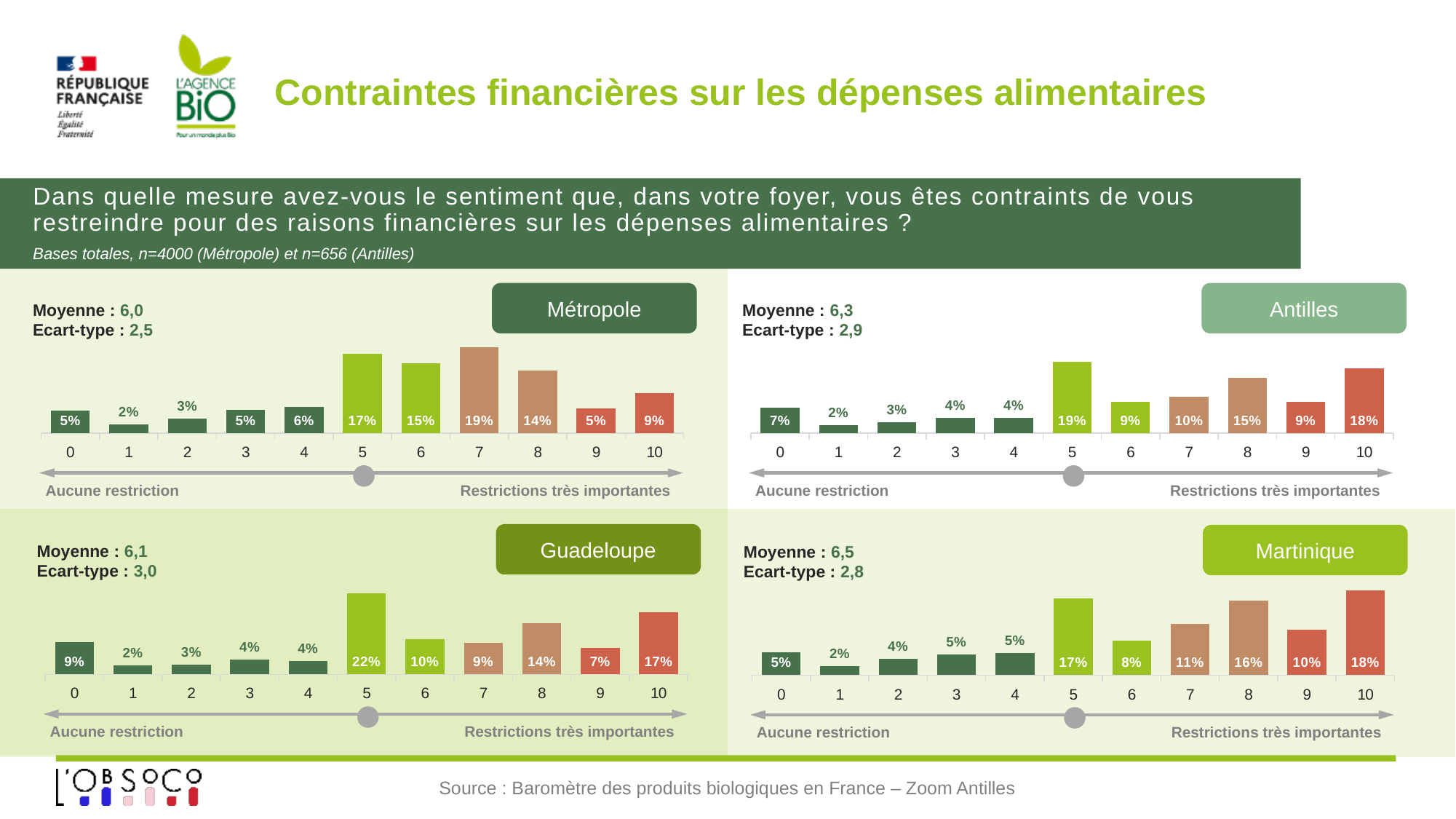
In the Métropole chart, what percentage of respondents gave a score of 7? 19% In the Antilles chart, what percentage of respondents gave a score of 10? 18% How many score categories are shown on the x axis of the Martinique chart? 11 In the Guadeloupe chart, which score has the highest percentage? 5 What is the mean (Moyenne) shown for the Martinique chart? 6,5 In the Martinique chart, which score has the lowest percentage? 1 In the Antilles chart, which score has the highest percentage? 5 In the Guadeloupe chart, what percentage of respondents gave a score of 0? 9% In the Martinique chart, what is the difference between the percentages for scores 10 and 9? 8% In the Métropole chart, what is the difference between the percentages for scores 5 and 6? 2% In the Antilles chart, which is larger: the percentage for score 5 or the percentage for score 10? score 5 What type of chart is used for the Métropole data? bar chart